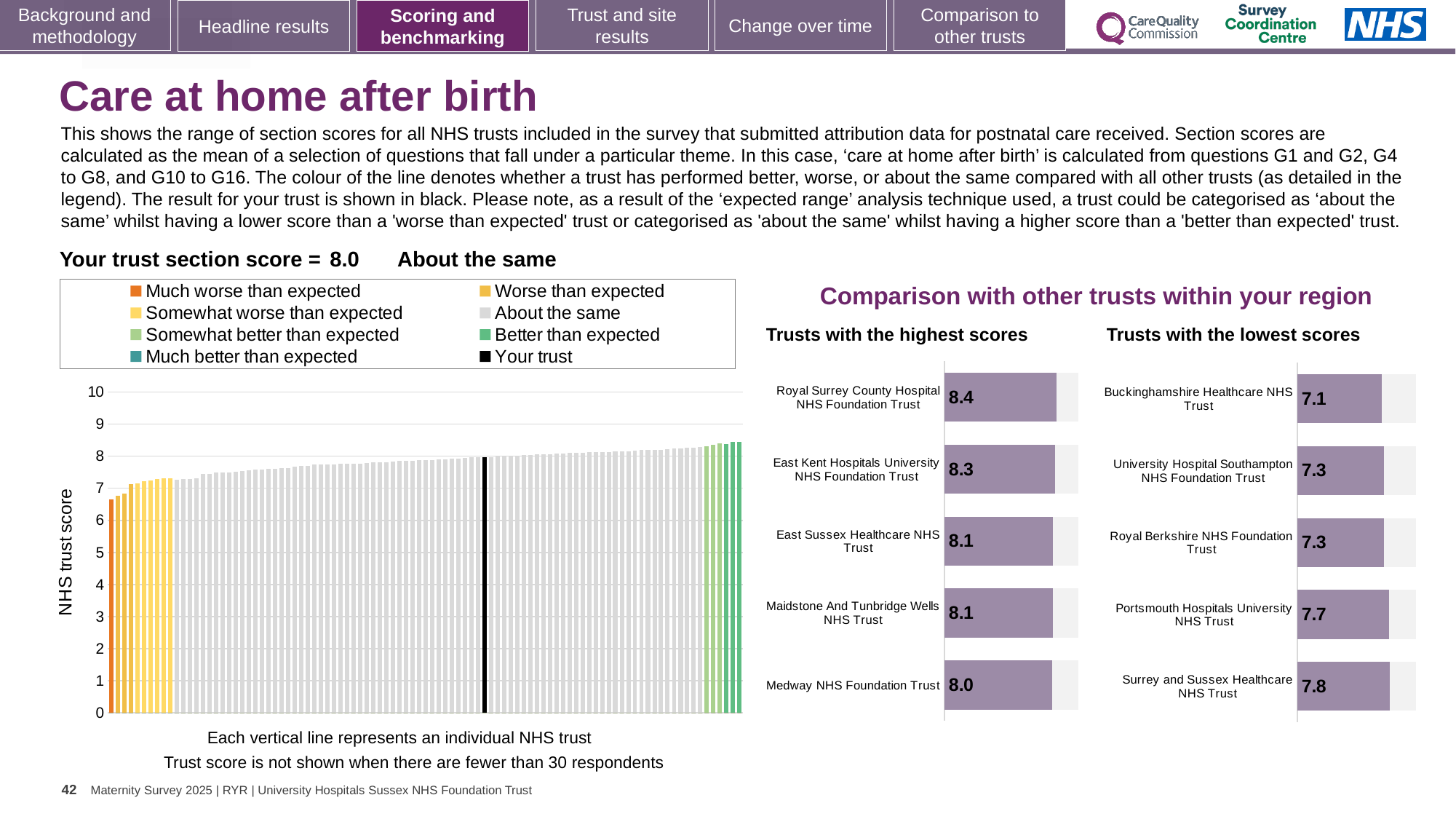
In the 'Trusts with the lowest scores' chart, which trust has the highest score? Surrey and Sussex Healthcare NHS Trust What is the label on the vertical axis of the large chart on the left? NHS trust score What type of chart is the large chart on the left showing NHS trust scores? Bar chart In the large chart on the left, do the NHS trust scores rise or fall from left to right? Rise In the 'Trusts with the lowest scores' chart, what is the difference between the scores of Surrey and Sussex Healthcare NHS Trust and Buckinghamshire Healthcare NHS Trust? 0.7 In the 'Trusts with the highest scores' chart, what is the score for Royal Surrey County Hospital NHS Foundation Trust? 8.4 How many entries does the legend above the large chart on the left list? 8 In the 'Trusts with the lowest scores' chart, which has the higher score: Portsmouth Hospitals University NHS Trust or University Hospital Southampton NHS Foundation Trust? Portsmouth Hospitals University NHS Trust In the 'Trusts with the highest scores' chart, what is the difference between the scores of Royal Surrey County Hospital NHS Foundation Trust and Medway NHS Foundation Trust? 0.4 In the 'Trusts with the highest scores' chart, which trust has the lowest score? Medway NHS Foundation Trust How many trusts are shown in the 'Trusts with the highest scores' chart? 5 In the 'Trusts with the lowest scores' chart, what is the score for Buckinghamshire Healthcare NHS Trust? 7.1